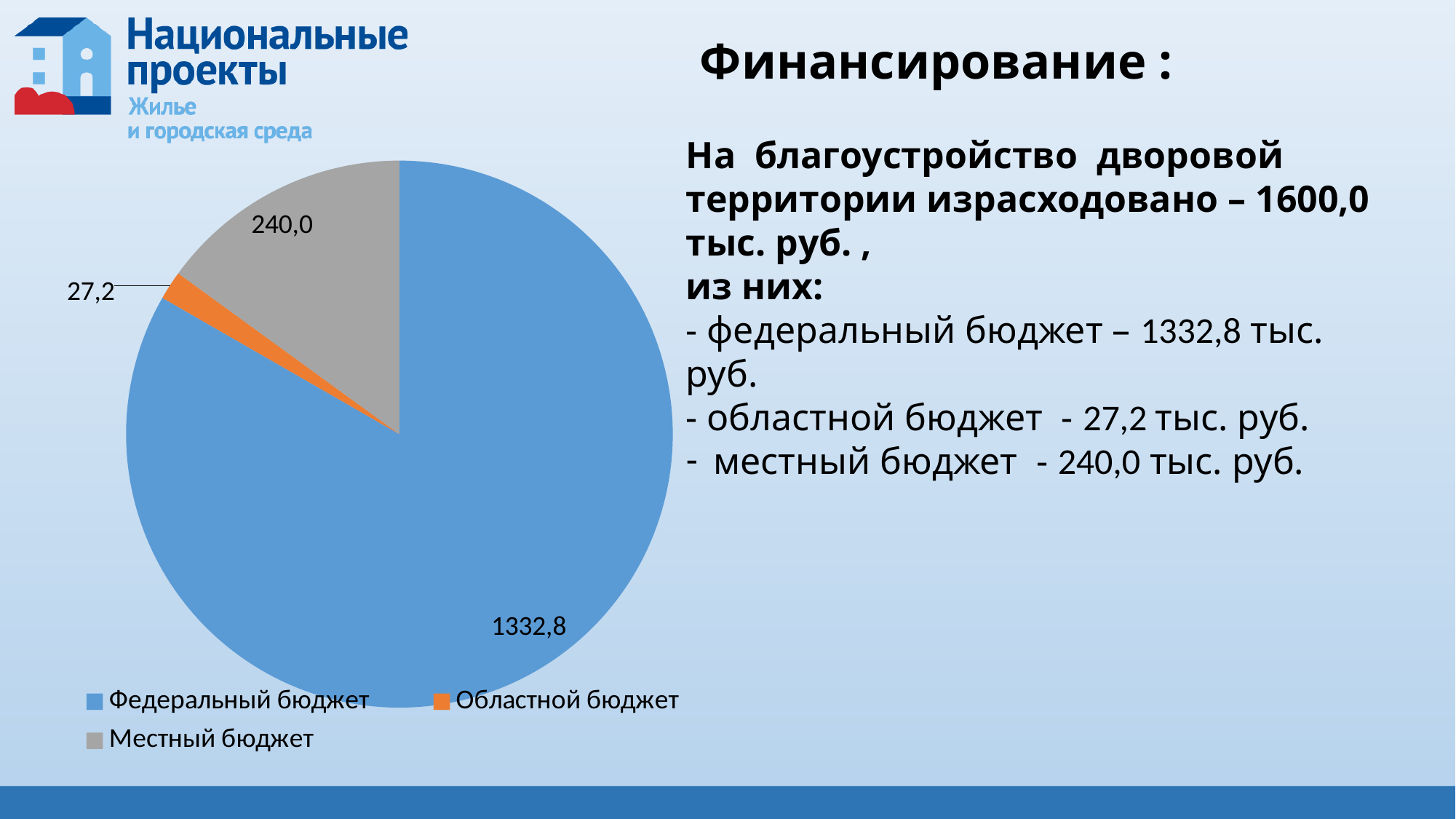
What is the value for Областной бюджет in the pie chart? 27,2 How many slices does the pie chart have? 3 What is the value for Федеральный бюджет in the pie chart? 1332,8 What is the difference between the values for Местный бюджет and Областной бюджет? 212,8 What is the difference between the values for Федеральный бюджет and Местный бюджет? 1092,8 What is the total of all slices in the pie chart? 1600,0 What share of the pie does Местный бюджет represent? 15% What is the value for Местный бюджет in the pie chart? 240,0 What type of chart is shown on the slide? pie chart Which category has the smallest slice in the pie chart? Областной бюджет Which is larger, the value for Местный бюджет or the value for Областной бюджет? Местный бюджет Which category has the largest slice in the pie chart? Федеральный бюджет